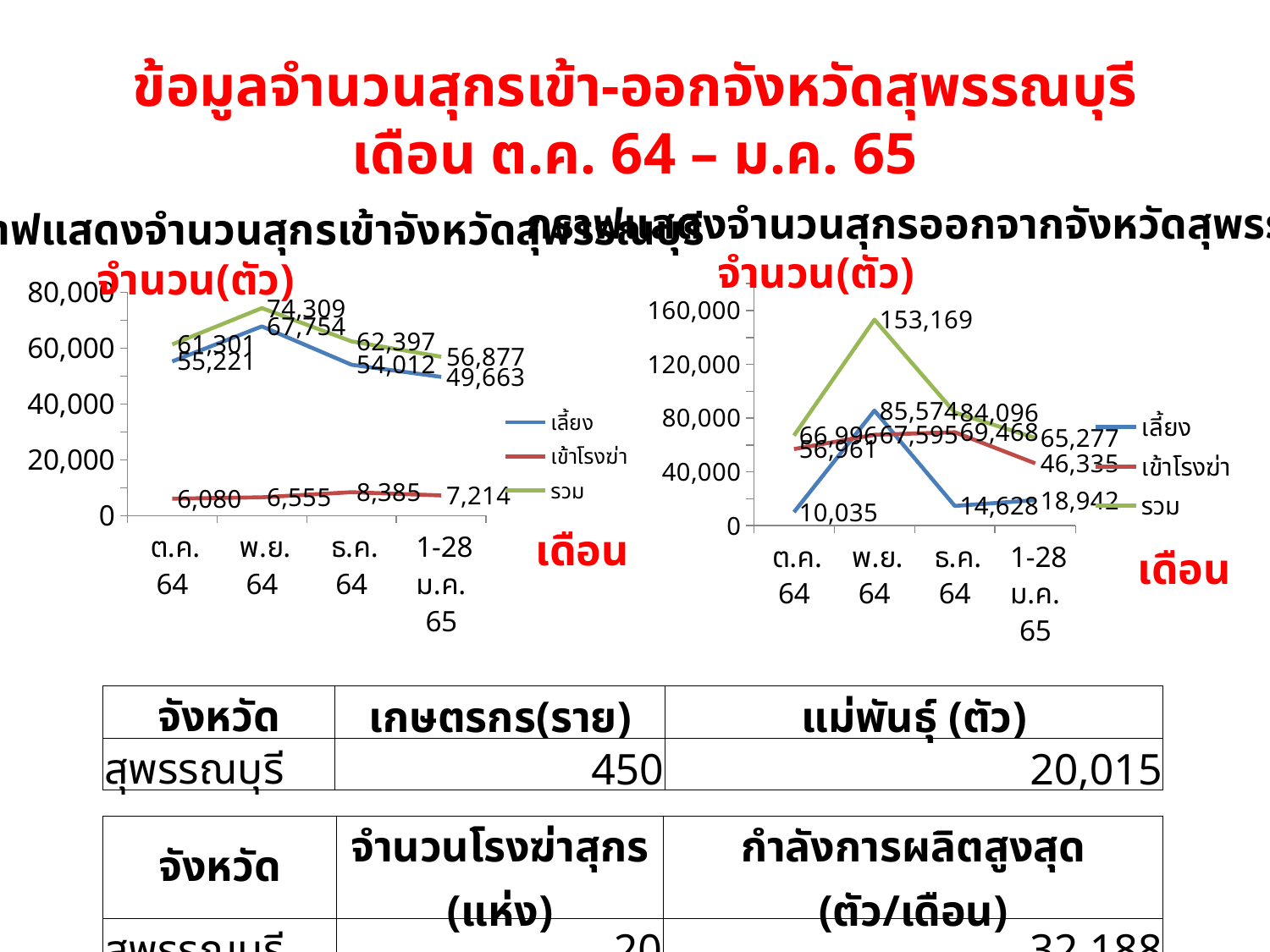
In the left chart, what is the difference between the รวม values for พ.ย. 64 and 1-28 ม.ค. 65? 17,432 In the left chart, which month has the highest value for เลี้ยง? พ.ย. 64 In the left chart, what is the value of เข้าโรงฆ่า for ธ.ค. 64? 8,385 In the right chart, what is the value of เลี้ยง for ต.ค. 64? 10,035 In the right chart, is the value of เลี้ยง for พ.ย. 64 greater or less than 80,000? greater In the right chart, which month has the lowest value for เข้าโรงฆ่า? 1-28 ม.ค. 65 In the right chart, what is the value of รวม for พ.ย. 64? 153,169 What type of chart is the left chart on the slide? line chart How many months are shown on the x axis of the right chart? 4 In the left chart, what is the value of รวม for พ.ย. 64? 74,309 In the right chart, which is larger for ธ.ค. 64: เลี้ยง or เข้าโรงฆ่า? เข้าโรงฆ่า How many series does the legend of the left chart list? 3